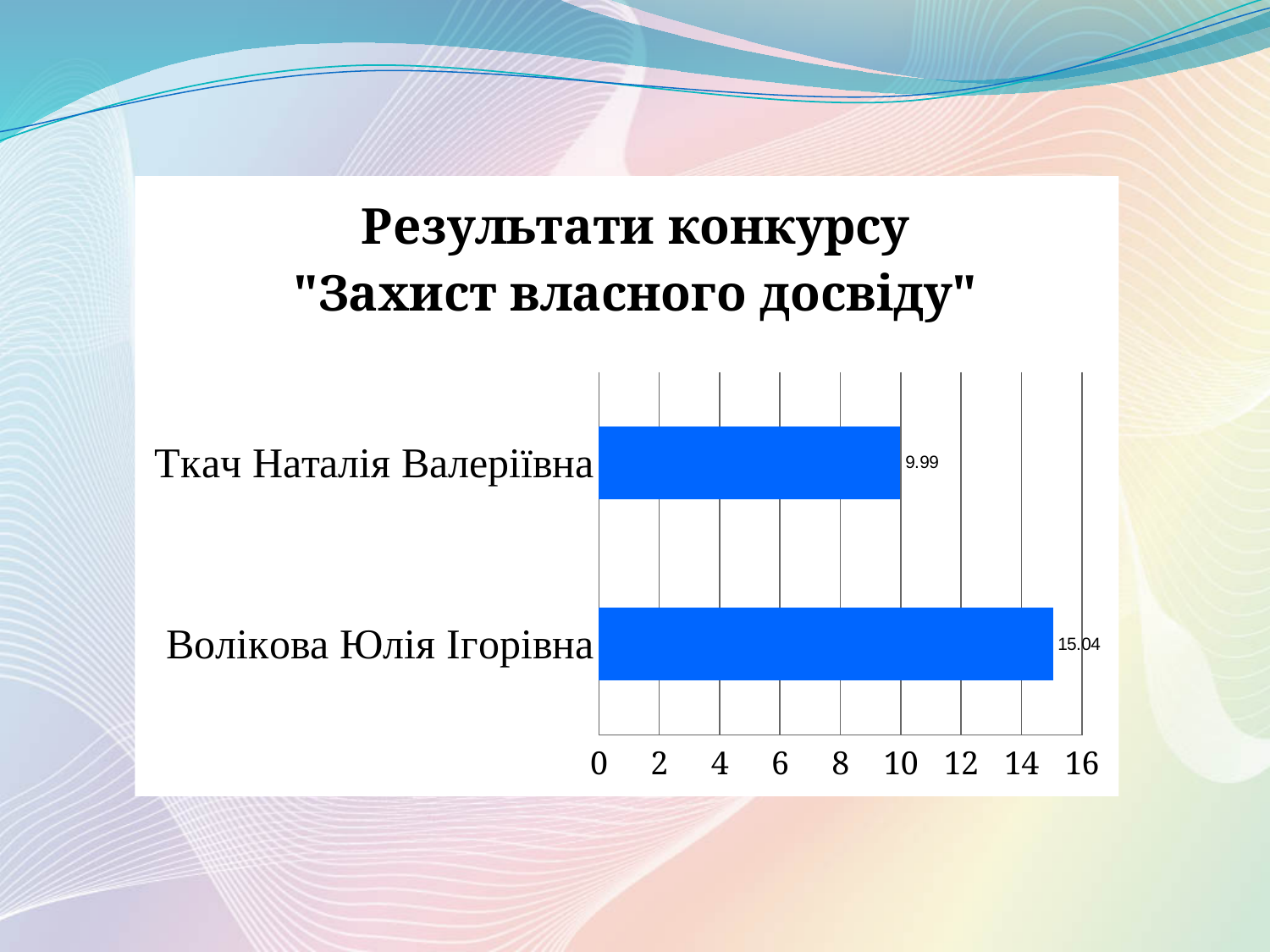
What is the maximum value shown on the horizontal axis? 16 What is the title of the chart? Результати конкурсу "Захист власного досвіду" Which category has the highest value? Волікова Юлія Ігорівна What is the value for Ткач Наталія Валеріївна? 9.99 Is the value for Волікова Юлія Ігорівна greater or less than 14? greater What is the value for Волікова Юлія Ігорівна? 15.04 Which is larger, the value for Ткач Наталія Валеріївна or the value for Волікова Юлія Ігорівна? Волікова Юлія Ігорівна Is the value for Ткач Наталія Валеріївна greater or less than 12? less What kind of chart is shown on the slide? bar chart How many categories are shown in the chart? 2 What is the difference between the values for Волікова Юлія Ігорівна and Ткач Наталія Валеріївна? 5.05 Which category has the lowest value? Ткач Наталія Валеріївна